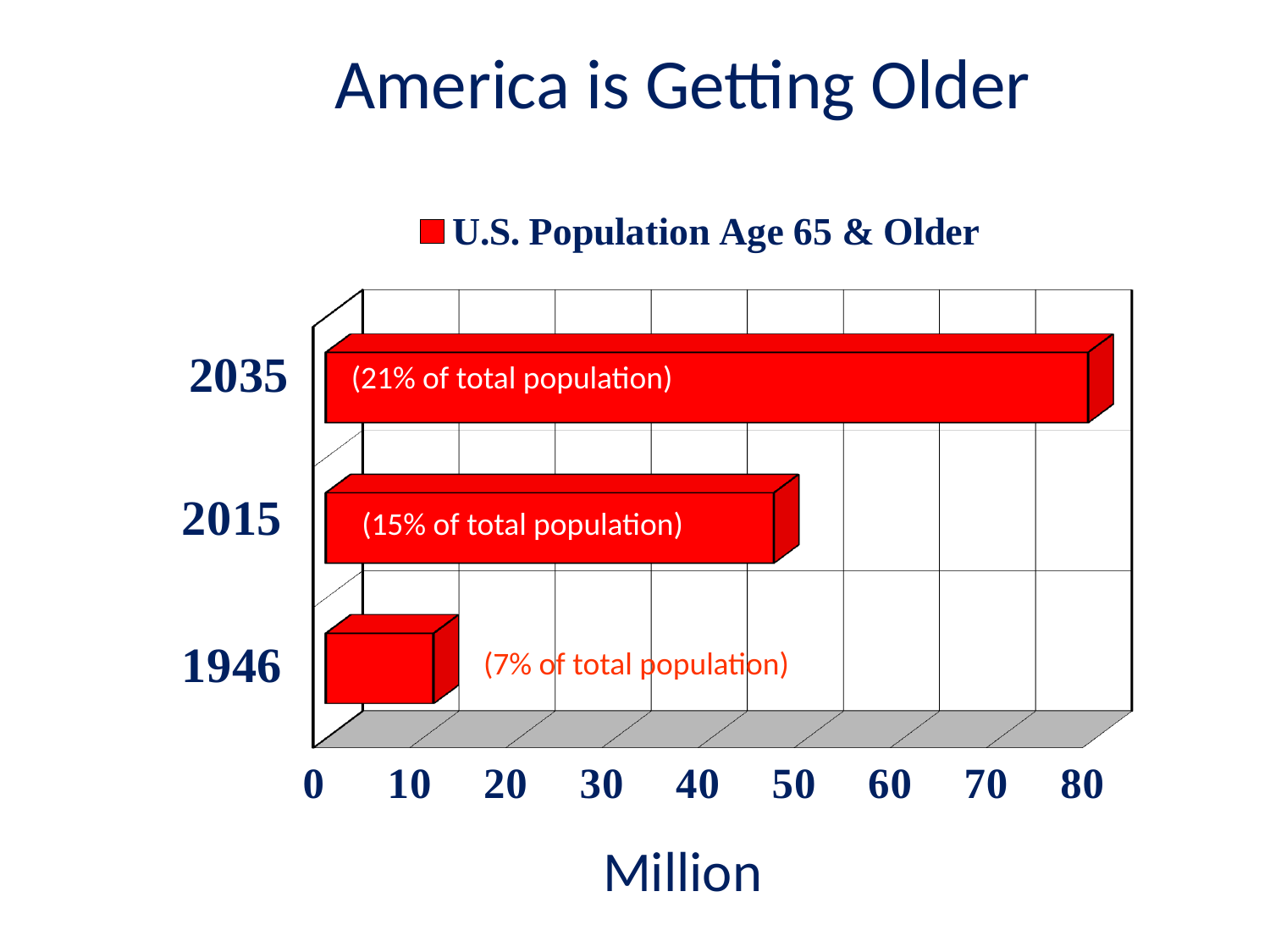
Which year has the highest value for U.S. Population Age 65 & Older? 2035 How many categories (years) are plotted in the chart? 3 What series name does the legend show? U.S. Population Age 65 & Older Which year has the lowest value for U.S. Population Age 65 & Older? 1946 According to the label on the 2035 bar, what percentage of the total population is age 65 and older? 21% Is the value for 2015 greater or less than 40 million? greater Which is larger, the value for 2015 or the value for 1946? 2015 Is the value for 2035 greater or less than 70 million? greater Do the values rise or fall as the years go from 1946 to 2035? rise How many series does the legend list? 1 What kind of chart is shown on the slide? bar chart Is the value for 1946 greater or less than 20 million? less